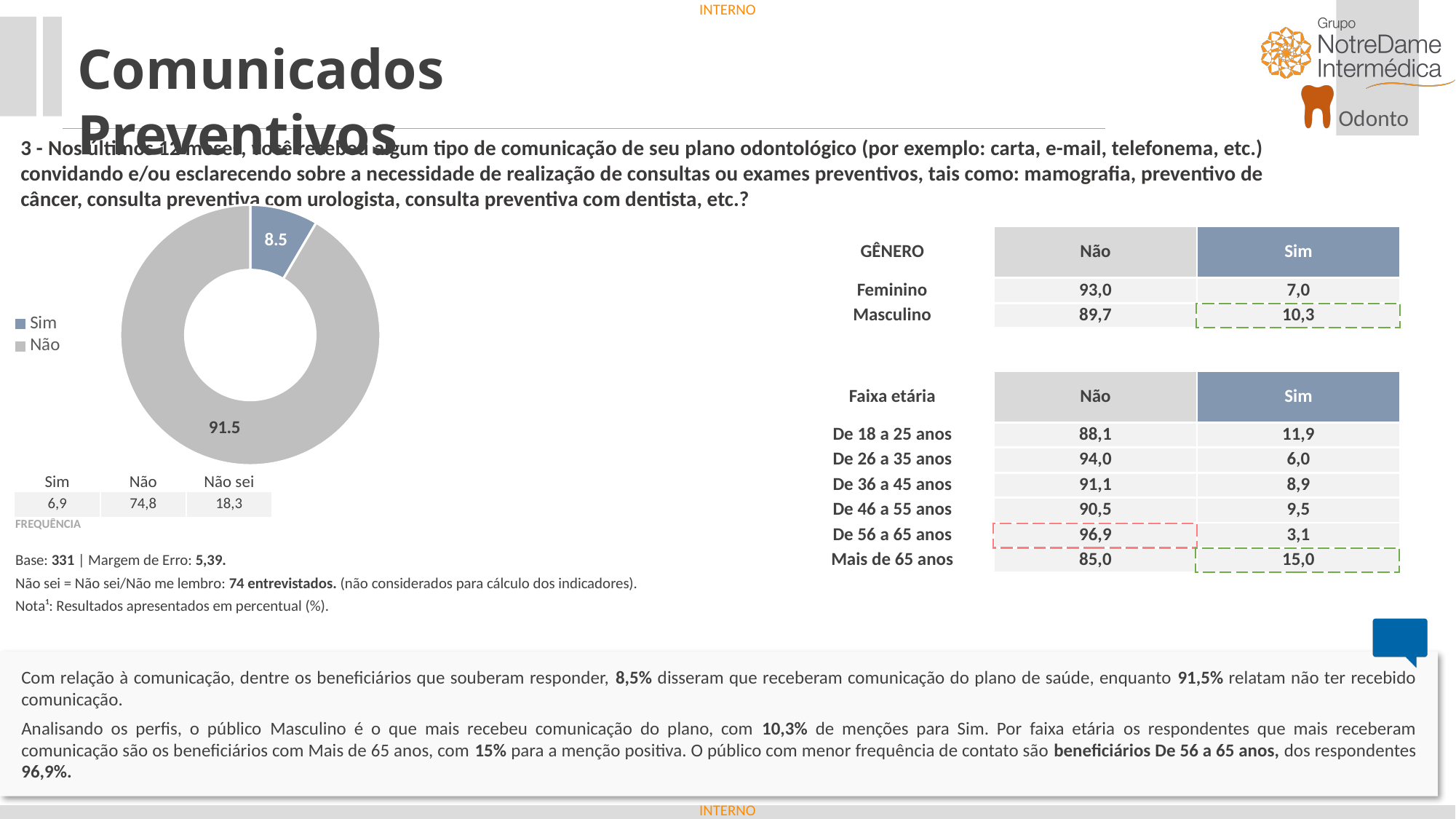
In the donut chart, what value is shown for Sim? 8.5 What are the legend entries of the donut chart? Sim, Não What share of the donut chart does the Sim slice represent? 8.5 How many slices does the donut chart have? 2 Which category has the smallest slice in the donut chart? Sim In the donut chart, which is larger, Sim or Não? Não How many entries does the legend of the donut chart list? 2 Which category has the largest slice in the donut chart? Não What is the difference between the Não and Sim values in the donut chart? 83 What kind of chart is shown on the slide? Donut (pie) chart Which colour is used for the Não slice in the donut chart? Grey In the donut chart, what value is shown for Não? 91.5